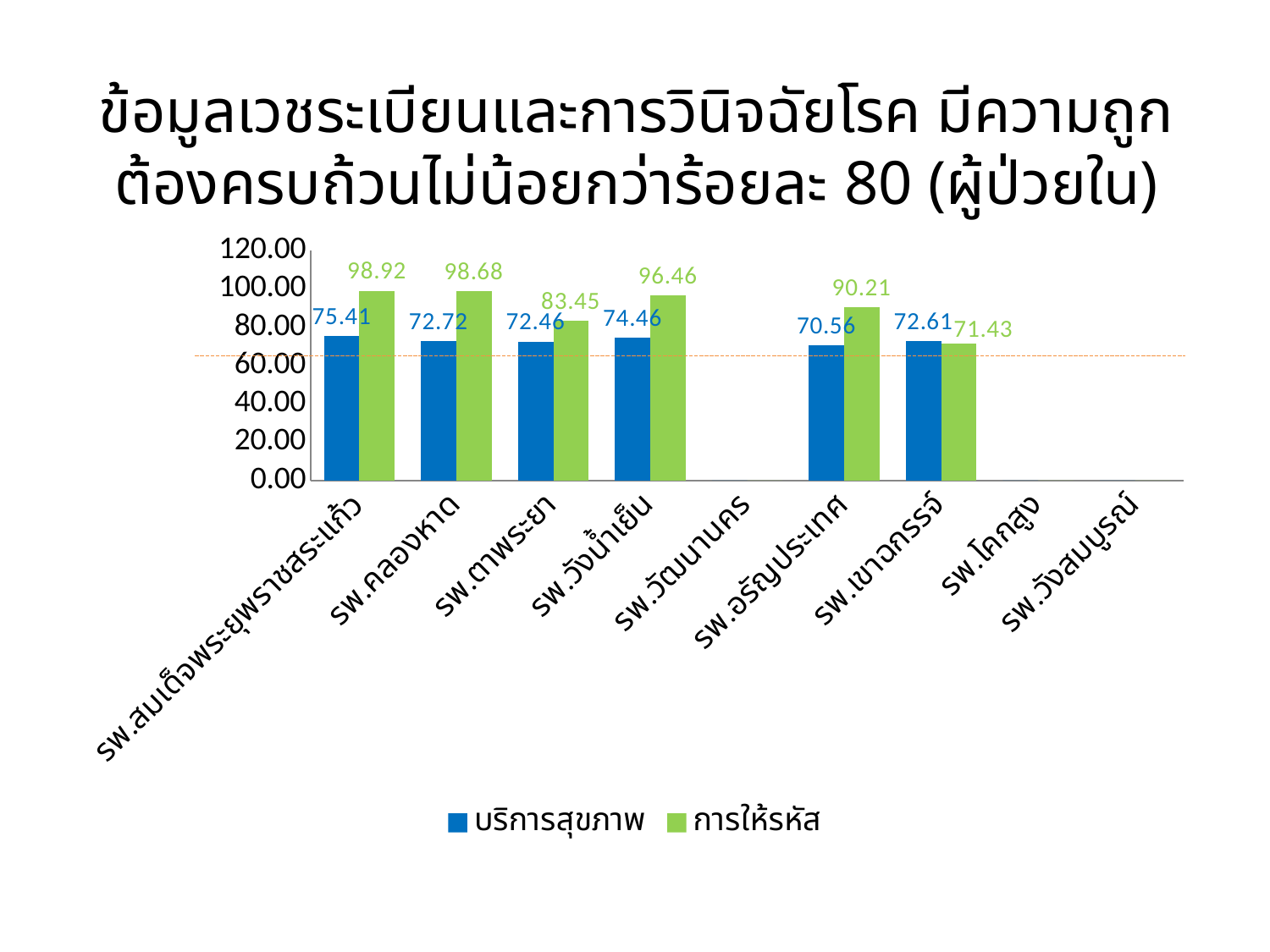
How many categories are shown on the x axis? 9 What is the value of การให้รหัส for รพ.ตาพระยา? 83.45 How many series does the legend list? 2 For รพ.เขาฉกรรจ์, which is larger: บริการสุขภาพ or การให้รหัส? บริการสุขภาพ Which category has the highest value for การให้รหัส? รพ.สมเด็จพระยุพราชสระแก้ว Which series is shown in green in the legend? การให้รหัส What is the value of การให้รหัส for รพ.คลองหาด? 98.68 What type of chart is shown on the slide? bar chart What is the value of บริการสุขภาพ for รพ.สมเด็จพระยุพราชสระแก้ว? 75.41 What is the difference between การให้รหัส and บริการสุขภาพ for รพ.วังน้ำเย็น? 22.00 Which category has the lowest value for บริการสุขภาพ among those with bars? รพ.อรัญประเทศ What is the value of บริการสุขภาพ for รพ.อรัญประเทศ? 70.56